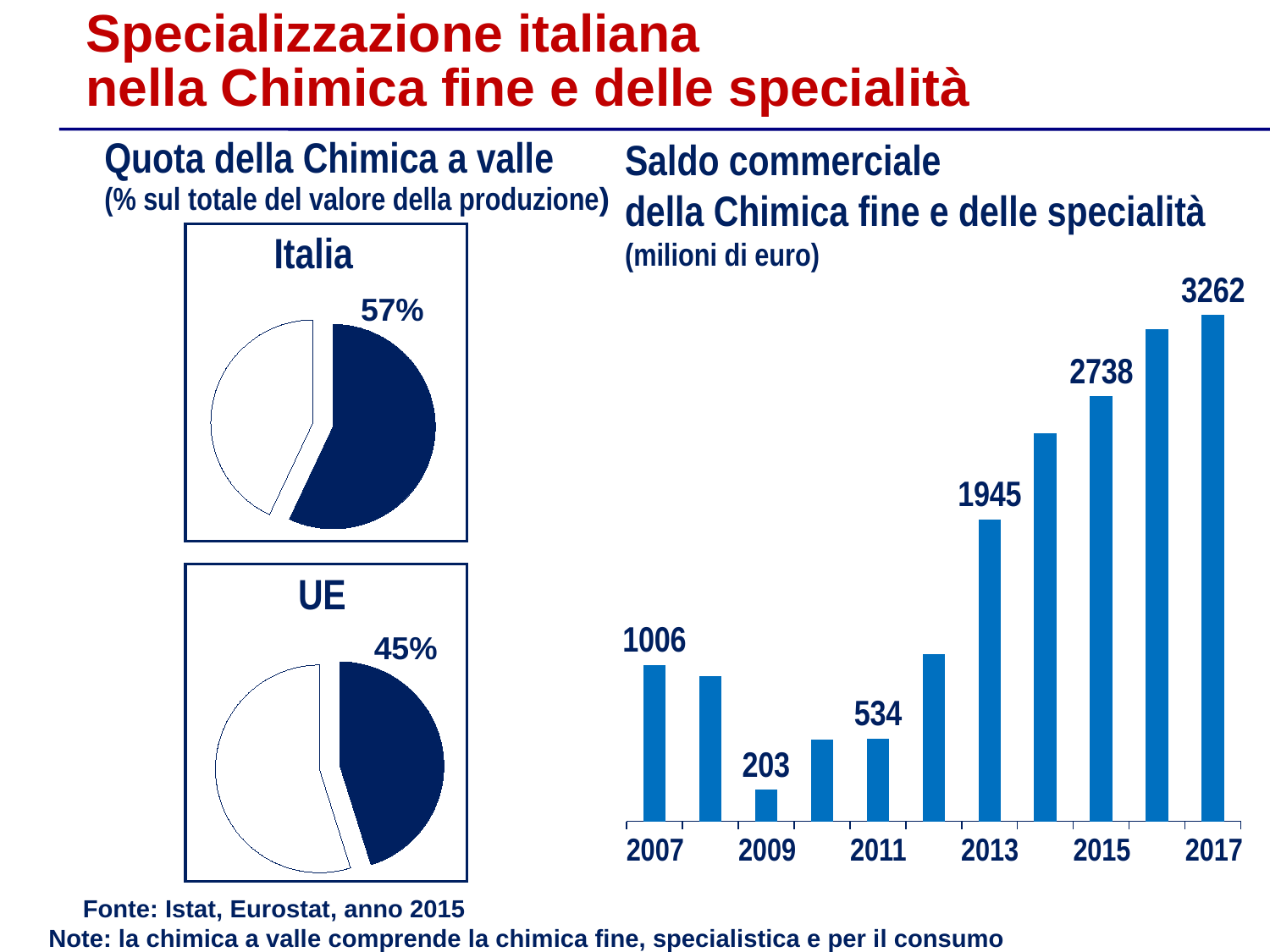
In the bar chart 'Saldo commerciale della Chimica fine e delle specialità', do the values generally rise or fall from 2009 to 2017? rise In the pie chart labelled 'UE', what share does the dark blue slice represent? 45% In the bar chart 'Saldo commerciale della Chimica fine e delle specialità', what is the value for 2017? 3262 What kind of chart is used for 'Saldo commerciale della Chimica fine e delle specialità'? bar chart In the bar chart 'Saldo commerciale della Chimica fine e delle specialità', what is the difference between the 2017 value and the 2015 value? 524 In the bar chart 'Saldo commerciale della Chimica fine e delle specialità', is the value for 2011 larger or smaller than the value for 2007? smaller In the bar chart 'Saldo commerciale della Chimica fine e delle specialità', which year has the lowest value? 2009 In the bar chart 'Saldo commerciale della Chimica fine e delle specialità', what is the value for 2009? 203 In the bar chart 'Saldo commerciale della Chimica fine e delle specialità', which year has the highest value? 2017 In the bar chart 'Saldo commerciale della Chimica fine e delle specialità', what is the value for 2013? 1945 In the pie chart labelled 'Italia', what share does the dark blue slice represent? 57% How many bars are plotted in the bar chart 'Saldo commerciale della Chimica fine e delle specialità'? 11